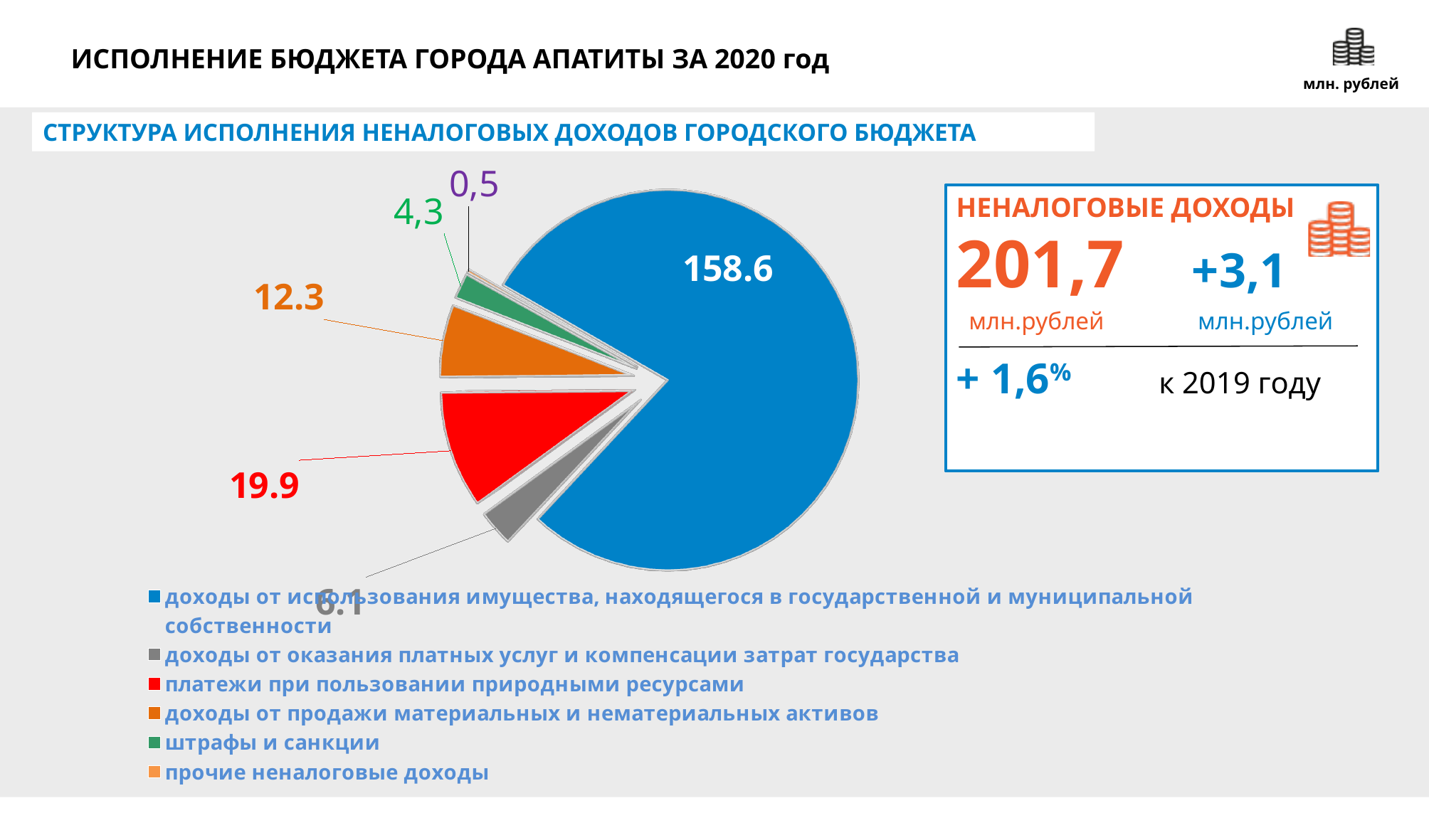
Which category has the largest slice of the pie? доходы от использования имущества, находящегося в государственной и муниципальной собственности How many categories does the legend list? 6 What is the value for штрафы и санкции? 4,3 Which category has the smallest slice of the pie? прочие неналоговые доходы What is the value for прочие неналоговые доходы? 0,5 What is the value for доходы от использования имущества, находящегося в государственной и муниципальной собственности? 158.6 Which is larger: платежи при пользовании природными ресурсами or доходы от продажи материальных и нематериальных активов? платежи при пользовании природными ресурсами What is the value for доходы от продажи материальных и нематериальных активов? 12.3 What colour is the slice for штрафы и санкции? green What is the difference between the values for платежи при пользовании природными ресурсами and доходы от продажи материальных и нематериальных активов? 7.6 What is the value for платежи при пользовании природными ресурсами? 19.9 What type of chart is shown on the slide? pie chart